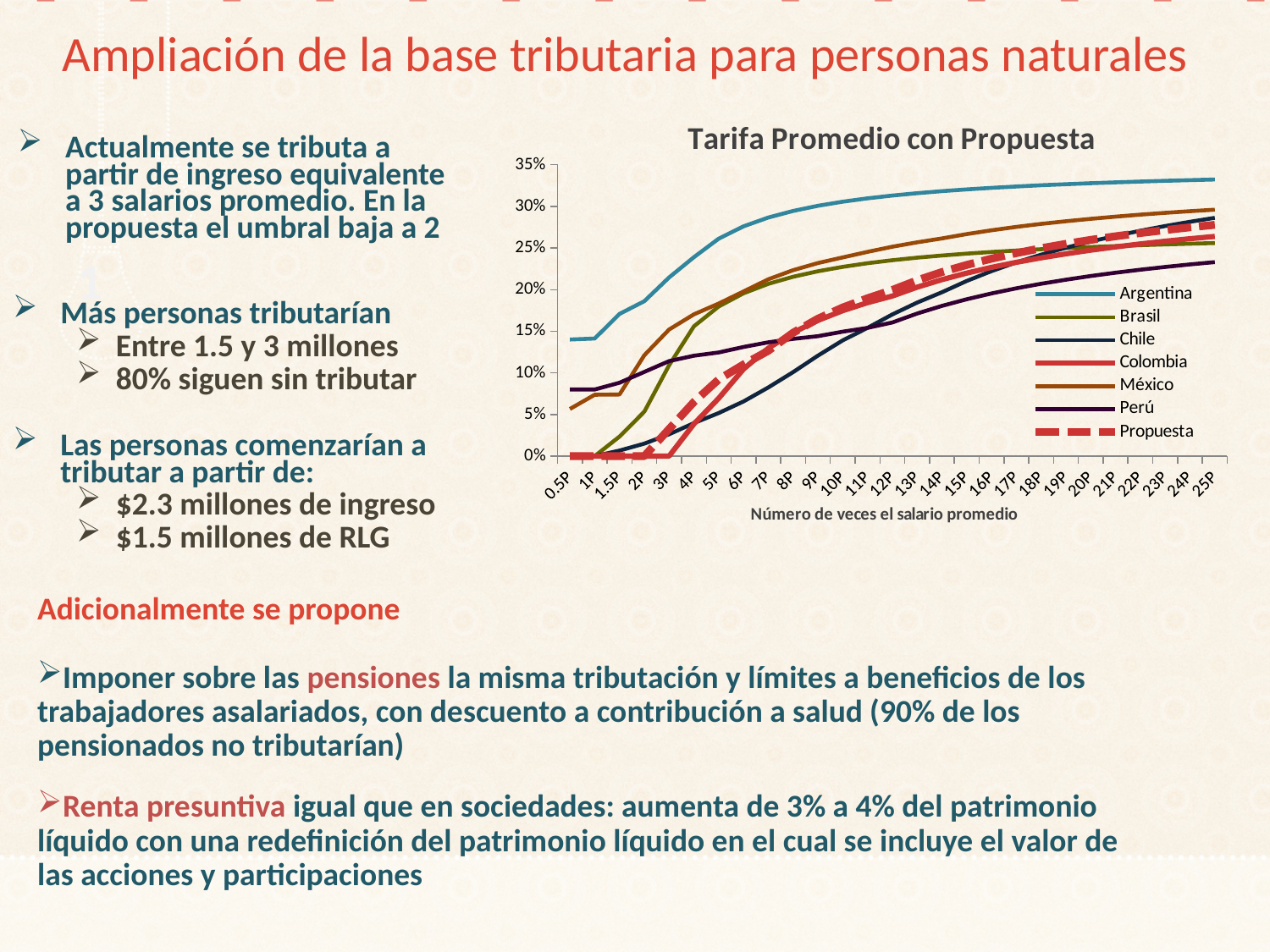
Is the value for Argentina at 0.5P greater or less than 10%? greater Which series has the highest value at 25P in the 'Tarifa Promedio con Propuesta' chart? Argentina What kind of chart is 'Tarifa Promedio con Propuesta'? Line chart Which series has the lowest value at 25P in the 'Tarifa Promedio con Propuesta' chart? Perú How many series does the legend of the 'Tarifa Promedio con Propuesta' chart list? 7 What is the x-axis title of the 'Tarifa Promedio con Propuesta' chart? Número de veces el salario promedio At 10P, which is larger: the value for Argentina or the value for Perú? Argentina Is the value for Perú at 25P greater or less than 25%? less Which series has the highest value at 0.5P in the 'Tarifa Promedio con Propuesta' chart? Argentina Does the Argentina line rise or fall as the number of times the average salary increases? Rises Is the value for Argentina at 25P greater or less than 30%? greater